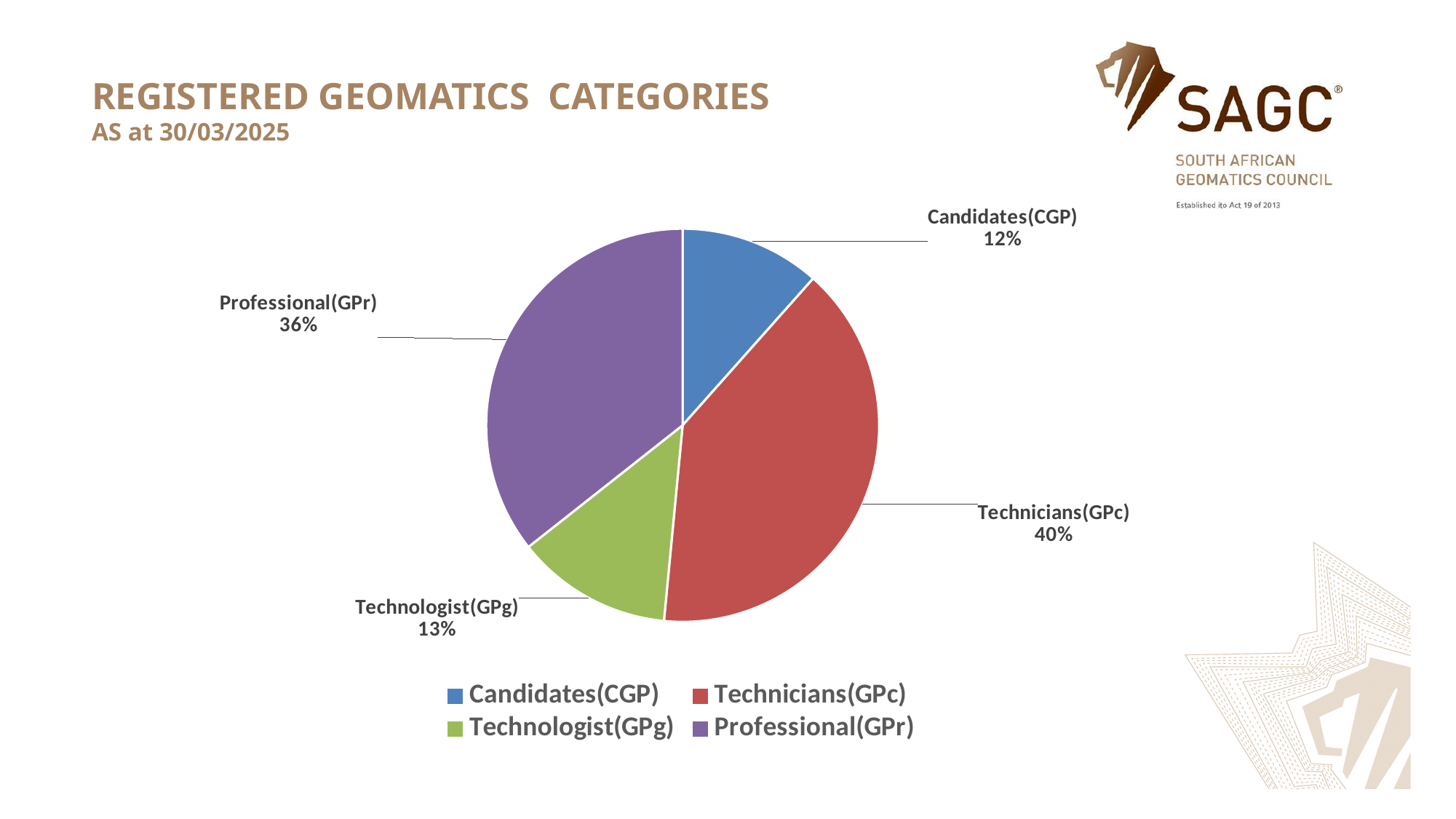
What share of the pie is Technologist(GPg)? 13% How many categories does the pie chart show? 4 What share of the pie is Candidates(CGP)? 12% What share of the pie is Technicians(GPc)? 40% What is the difference in percentage points between Technologist(GPg) and Candidates(CGP)? 1 What kind of chart is shown on the slide? Pie chart What colour is the Technicians(GPc) slice? Red What is the difference in percentage points between Technicians(GPc) and Professional(GPr)? 4 Which category has the smallest share of the pie? Candidates(CGP) Which category has the largest share of the pie? Technicians(GPc) Which is larger, the share for Professional(GPr) or the share for Technologist(GPg)? Professional(GPr)